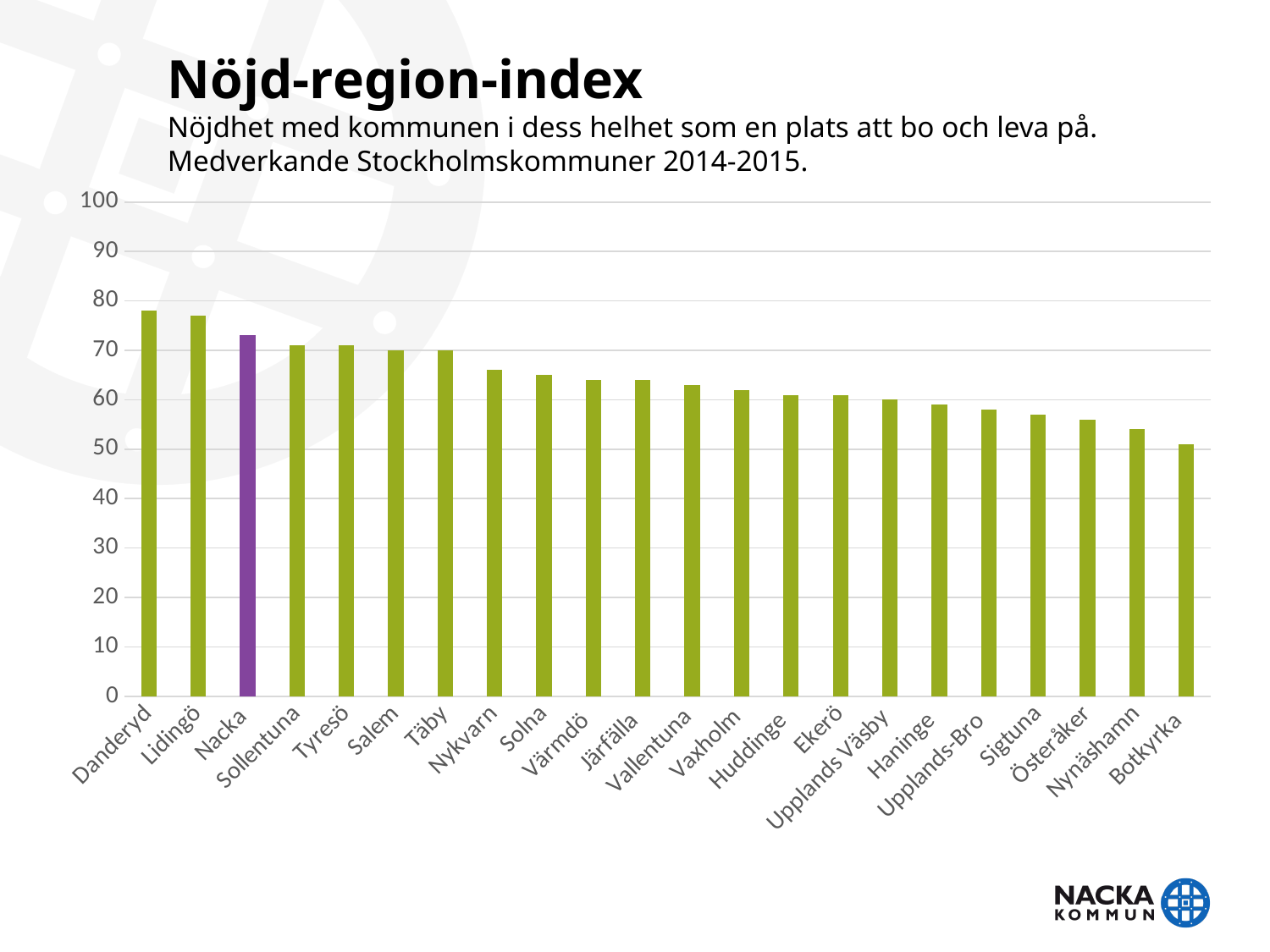
Which has a higher value, Danderyd or Nacka? Danderyd Which municipality's bar is shown in purple instead of green? Nacka Which municipality has the lowest Nöjd-region-index value? Botkyrka Do the values rise or fall moving from left to right along the x axis? fall How many municipalities (bars) are shown in the chart? 22 Is the value for Nynäshamn greater or less than 60? less Is the value for Nacka greater or less than 70? greater Is the value for Solna greater or less than 70? less What kind of chart is shown on the slide? bar chart Which has a higher value, Nacka or Botkyrka? Nacka